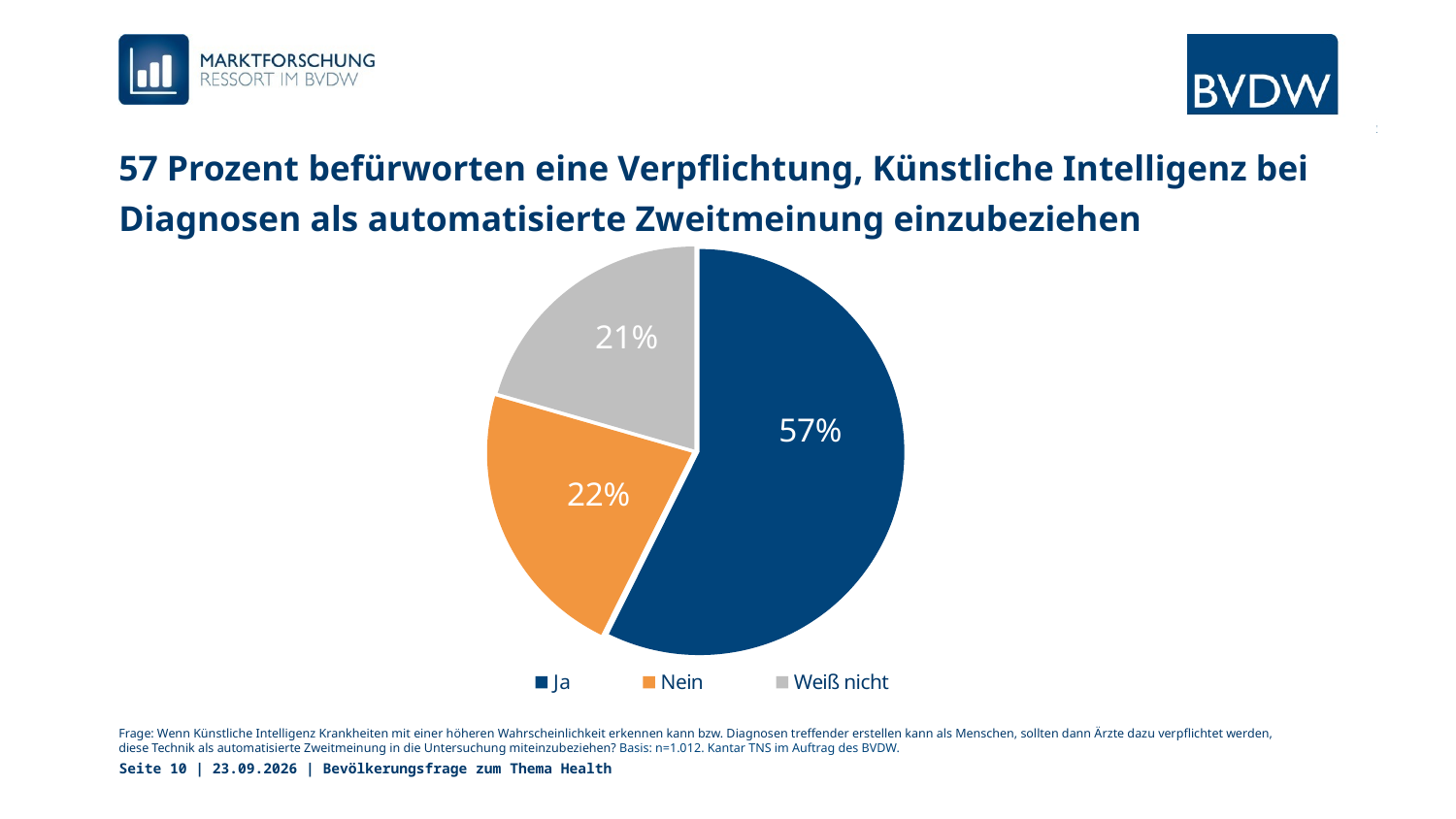
What kind of chart is shown on the slide? Pie chart How many entries does the legend list? 3 What is the difference in percentage points between "Nein" and "Weiß nicht"? 1 How many slices does the pie chart have? 3 Which is larger, the share for "Ja" or the share for "Nein"? Ja What percentage of respondents answered "Ja"? 57% What percentage of respondents answered "Weiß nicht"? 21% What percentage of respondents answered "Nein"? 22% Which answer has the smallest share of the pie? Weiß nicht What colour is the "Nein" slice? Orange What is the difference in percentage points between "Ja" and "Nein"? 35 Which answer has the largest share of the pie? Ja